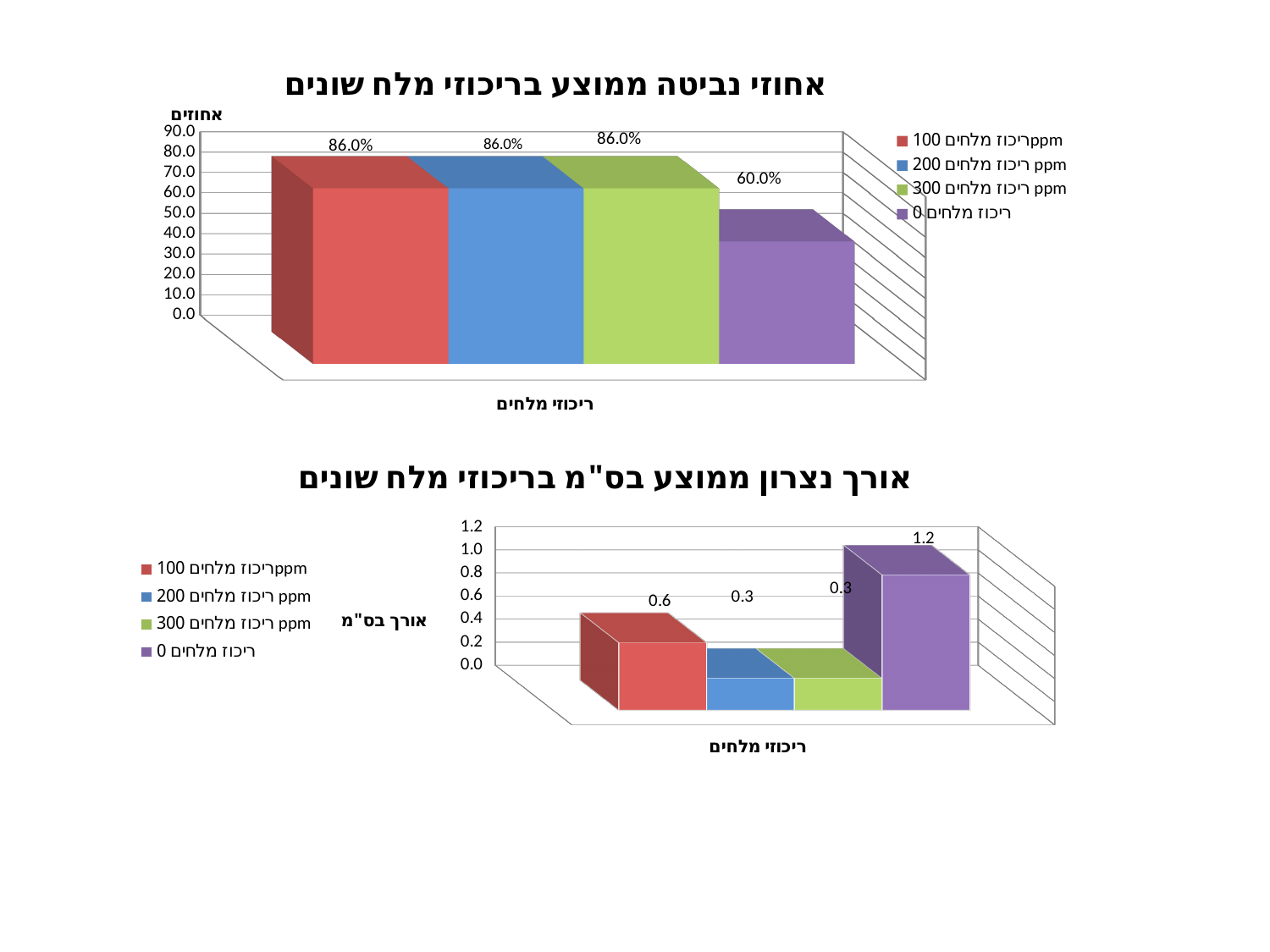
In the top chart (אחוזי נביטה ממוצע בריכוזי מלח שונים), what is the value for ריכוז מלחים 100ppm? 86.0% What kind of chart is the top chart (אחוזי נביטה ממוצע בריכוזי מלח שונים)? bar chart In the bottom chart (אורך נצרון ממוצע בס"מ בריכוזי מלח שונים), what is the value for ריכוז מלחים 100ppm? 0.6 In the top chart (אחוזי נביטה ממוצע בריכוזי מלח שונים), what is the value for ריכוז מלחים 0? 60.0% In the top chart (אחוזי נביטה ממוצע בריכוזי מלח שונים), what is the difference between the value for ריכוז מלחים 200 ppm and the value for ריכוז מלחים 0? 26.0% In the bottom chart (אורך נצרון ממוצע בס"מ בריכוזי מלח שונים), what is the value for ריכוז מלחים 0? 1.2 In the bottom chart (אורך נצרון ממוצע בס"מ בריכוזי מלח שונים), which series has the highest value? ריכוז מלחים 0 In the top chart (אחוזי נביטה ממוצע בריכוזי מלח שונים), which series has the lowest value? ריכוז מלחים 0 In the top chart (אחוזי נביטה ממוצע בריכוזי מלח שונים), how many series does the legend list? 4 In the bottom chart (אורך נצרון ממוצע בס"מ בריכוזי מלח שונים), which is larger: the value for ריכוז מלחים 100ppm or the value for ריכוז מלחים 300 ppm? ריכוז מלחים 100ppm In the bottom chart (אורך נצרון ממוצע בס"מ בריכוזי מלח שונים), what is the difference between the value for ריכוז מלחים 0 and the value for ריכוז מלחים 200 ppm? 0.9 In the bottom chart (אורך נצרון ממוצע בס"מ בריכוזי מלח שונים), what colour is the bar for ריכוז מלחים 0? purple